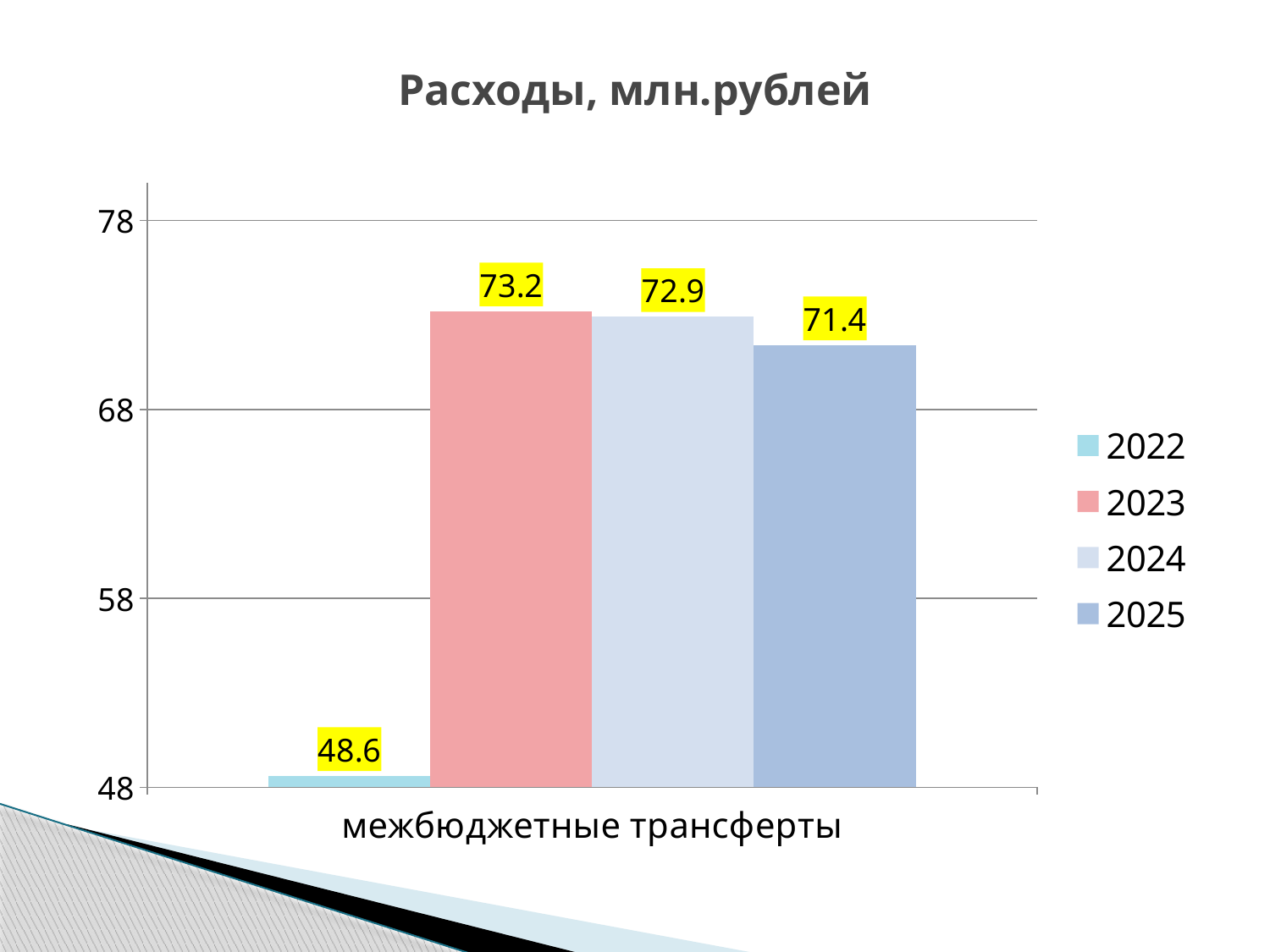
How many series does the legend list? 4 What is the value for 2025 for межбюджетные трансферты? 71.4 What is the value for 2022 for межбюджетные трансферты? 48.6 What is the value for 2023 for межбюджетные трансферты? 73.2 Which year has the lowest value? 2022 What is the difference between the 2024 value and the 2025 value? 1.5 What kind of chart is shown? bar chart Which is larger, the value for 2022 or the value for 2025? 2025 Which year has the highest value? 2023 What is the title of the chart? Расходы, млн.рублей What is the value for 2024 for межбюджетные трансферты? 72.9 What is the difference between the 2023 value and the 2022 value? 24.6